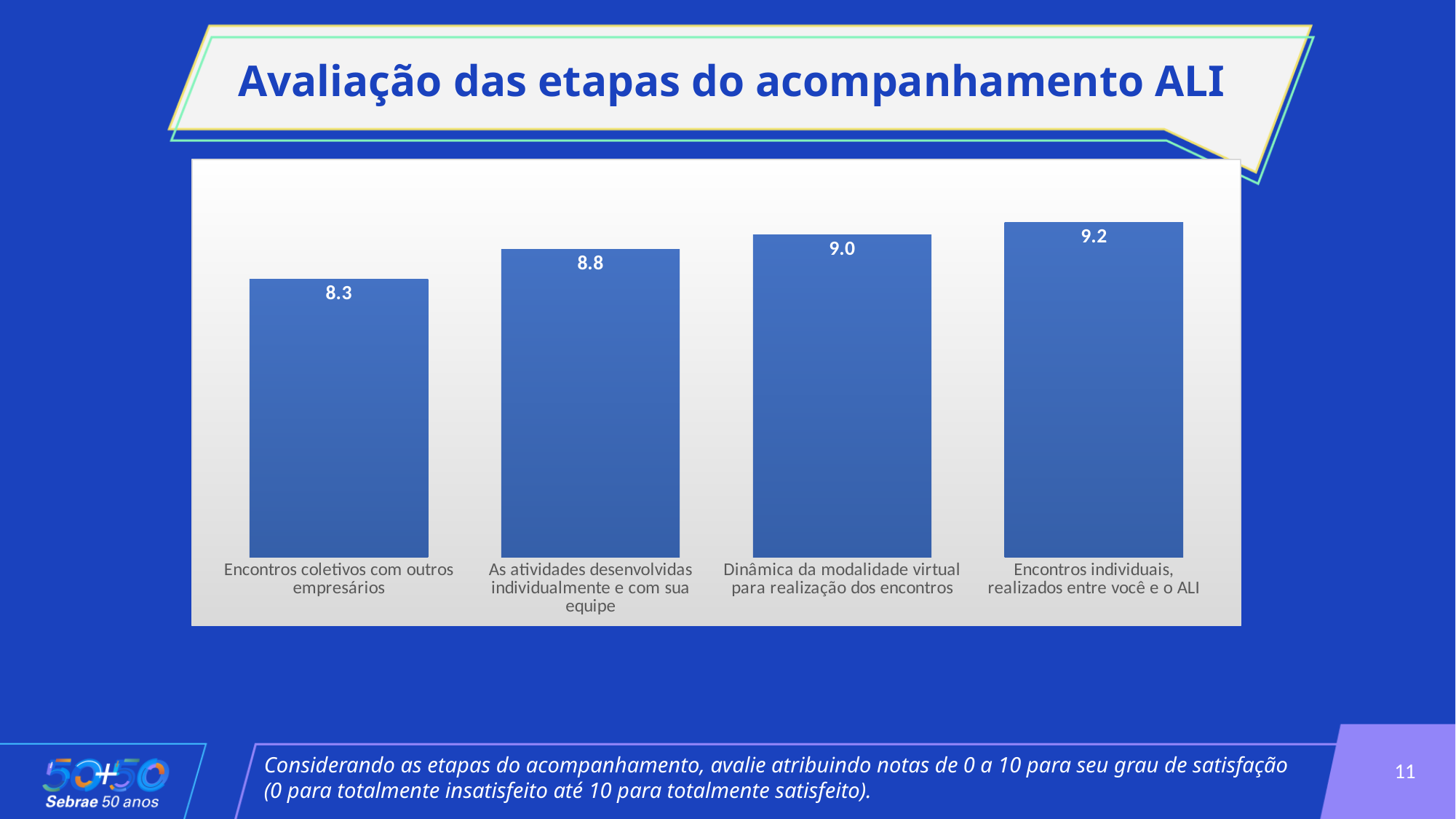
Which category has the highest value? Encontros individuais, realizados entre você e o ALI What is the value for "As atividades desenvolvidas individualmente e com sua equipe"? 8.8 What is the value for "Encontros individuais, realizados entre você e o ALI"? 9.2 What is the difference between the values for "Encontros individuais, realizados entre você e o ALI" and "Encontros coletivos com outros empresários"? 0.9 Do the values rise or fall from left to right across the categories? Rise What is the value for "Dinâmica da modalidade virtual para realização dos encontros"? 9.0 What is the difference between the values for "Dinâmica da modalidade virtual para realização dos encontros" and "As atividades desenvolvidas individualmente e com sua equipe"? 0.2 Which is larger: the value for "As atividades desenvolvidas individualmente e com sua equipe" or the value for "Encontros coletivos com outros empresários"? As atividades desenvolvidas individualmente e com sua equipe What kind of chart is shown on the slide? Bar chart What is the value for "Encontros coletivos com outros empresários"? 8.3 Which category has the lowest value? Encontros coletivos com outros empresários How many categories are shown in the chart? 4